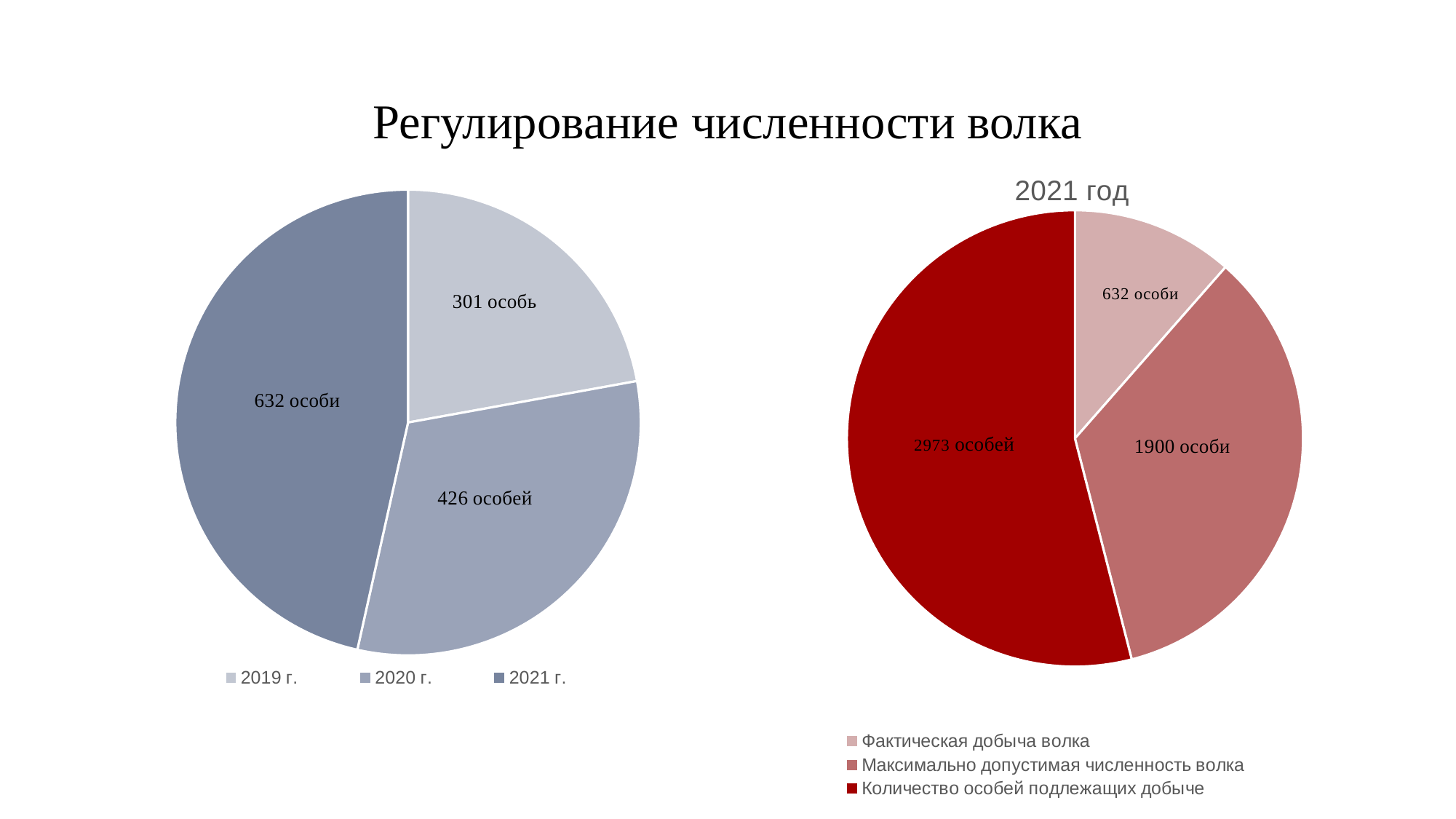
What type of chart is the left chart on the slide? pie chart In the chart titled '2021 год', what is the value for 'Максимально допустимая численность волка'? 1900 особи In the left pie chart, which year has the largest slice? 2021 г. How many entries does the legend of the chart titled '2021 год' list? 3 How many slices does the left pie chart have? 3 In the chart titled '2021 год', what is the difference between 'Количество особей подлежащих добыче' and 'Максимально допустимая численность волка'? 1073 In the chart titled '2021 год', what is the value for 'Фактическая добыча волка'? 632 особи In the left pie chart, which year has the smallest slice? 2019 г. In the left pie chart, what is the difference between the values for 2021 г. and 2019 г.? 331 In the left pie chart, what is the value for 2019 г.? 301 особь In the chart titled '2021 год', which category has the largest slice? Количество особей подлежащих добыче In the left pie chart, what is the value for 2020 г.? 426 особей